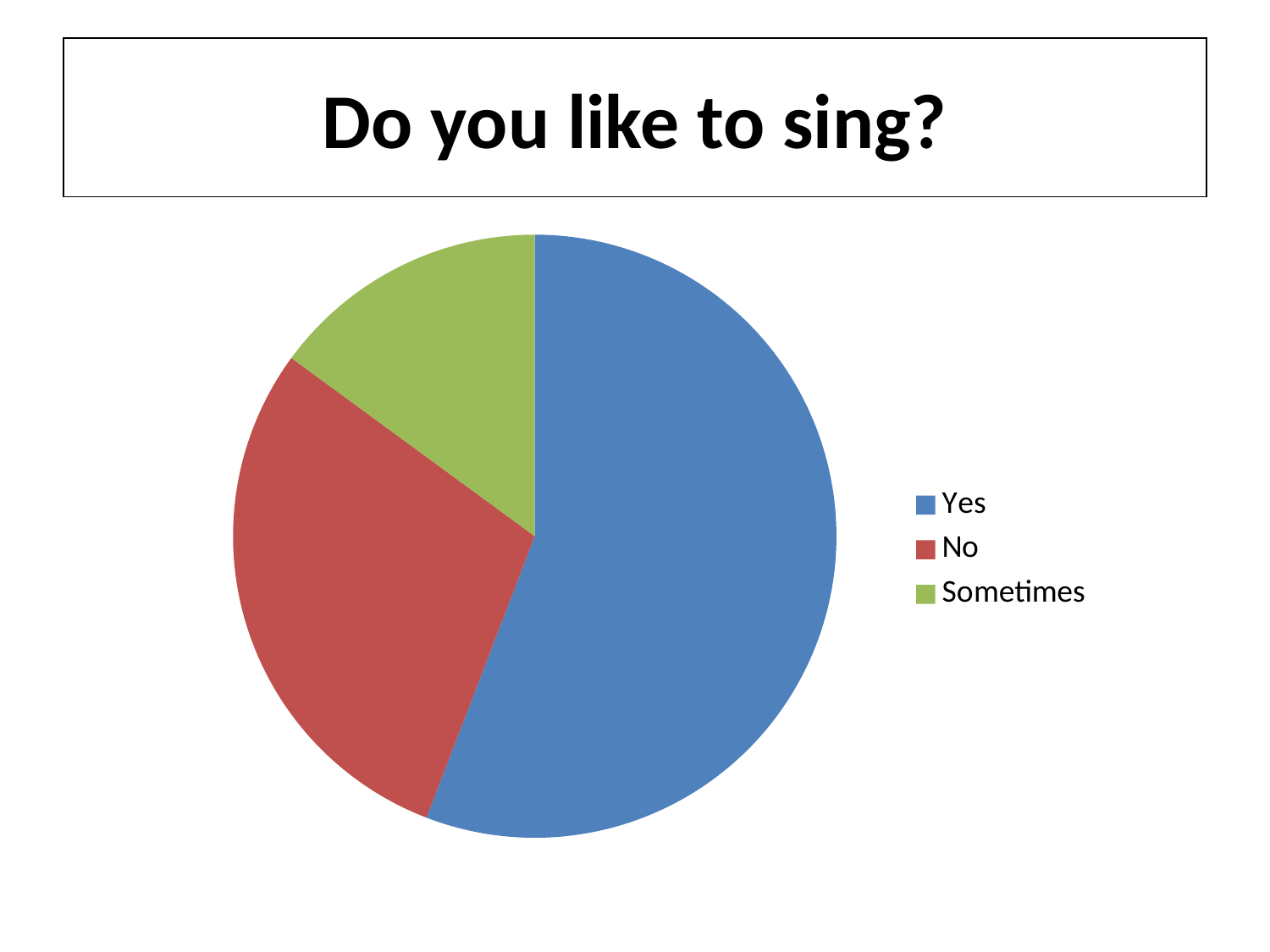
Which slice is larger, No or Sometimes? No Which slice is larger, Yes or No? Yes Which category has the smallest slice of the pie? Sometimes What kind of chart is shown on the slide? Pie chart Which category has the largest slice of the pie? Yes How many entries does the legend list? 3 How many slices does the pie chart have? 3 What is the title of the slide? Do you like to sing? Which colour represents the Sometimes category? Green Which category is shown in blue? Yes